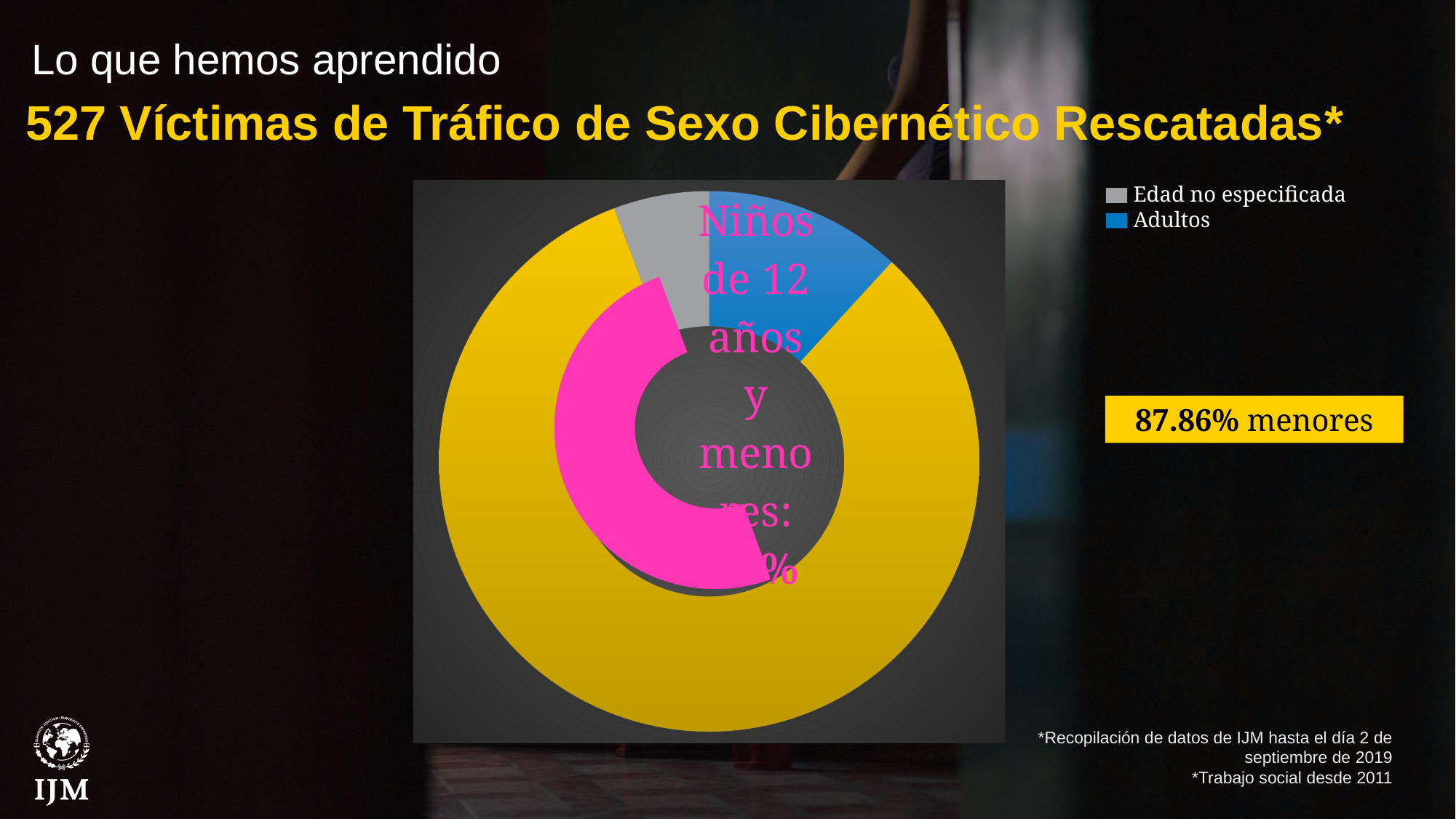
How many cybersex trafficking victims were rescued in total, according to the slide title? 527 How many entries does the chart's legend list? 2 Which slice of the outer ring is the smallest? Edad no especificada What kind of chart is shown on the slide? Doughnut (pie) chart Which legend entry is shown in gray? Edad no especificada Which legend entry is shown in blue? Adultos What group does the pink inner ring represent? Niños de 12 años y menores Which slice of the outer ring is the largest? The yellow slice (menores) What percentage of the rescued victims were minors (menores), according to the slide? 87.86% Which is larger in the outer ring: the Adultos slice or the Edad no especificada slice? Adultos Is the share of minors (menores) greater or less than 50%? greater